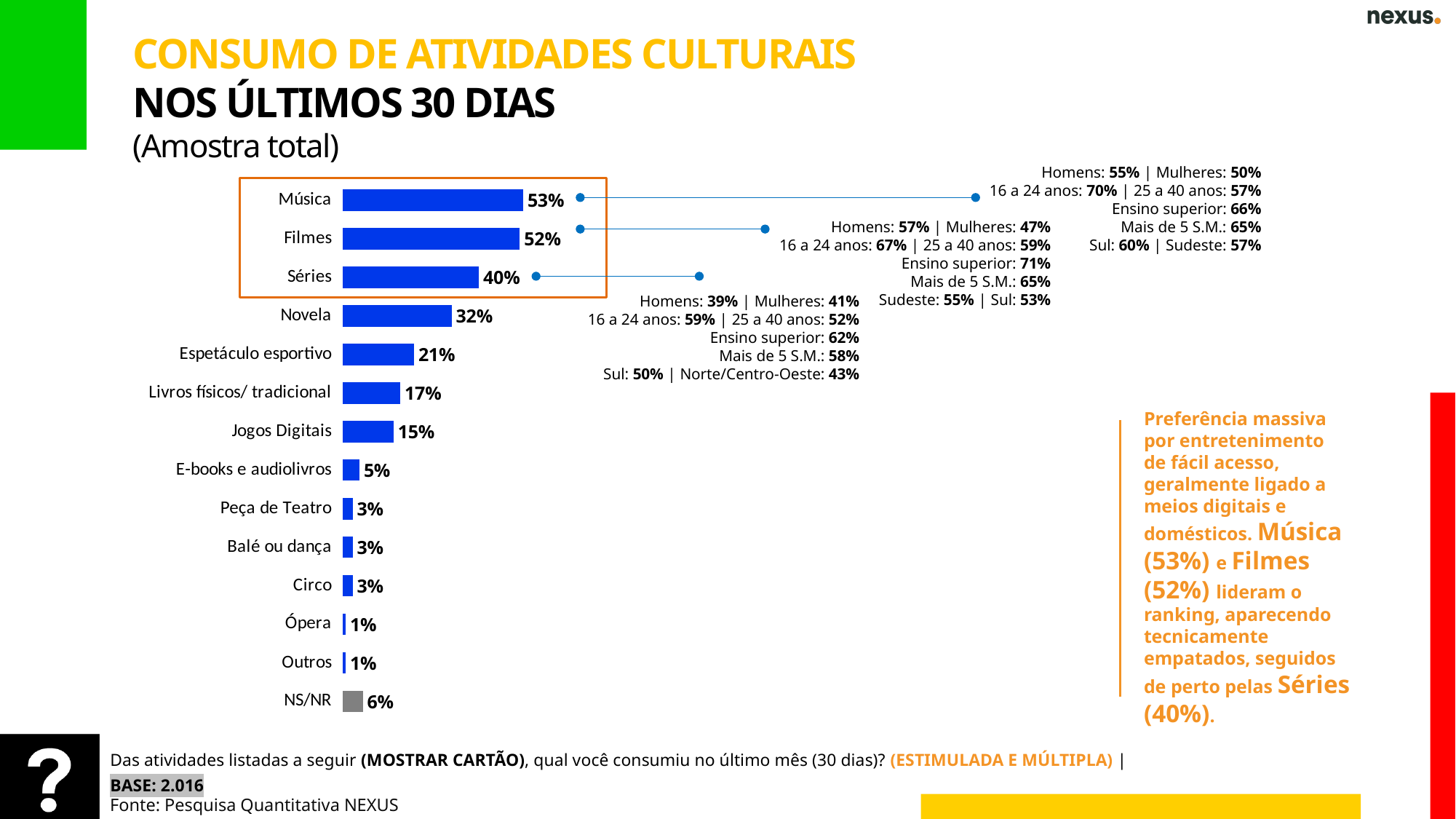
What is the value for Novela? 32% What is the value for NS/NR? 6% How many categories are shown in the chart? 14 Which is larger, the value for Novela or the value for Séries? Séries What is the value for Livros físicos/ tradicional? 17% Which category has the highest value? Música What is the difference between the values for Espetáculo esportivo and E-books e audiolivros? 16% Which bar is drawn in grey rather than blue? NS/NR What is the difference between the values for Música and Séries? 13% What is the value for Jogos Digitais? 15% What kind of chart is shown on the slide? Bar chart Which categories are tied at 3%? Peça de Teatro, Balé ou dança, Circo